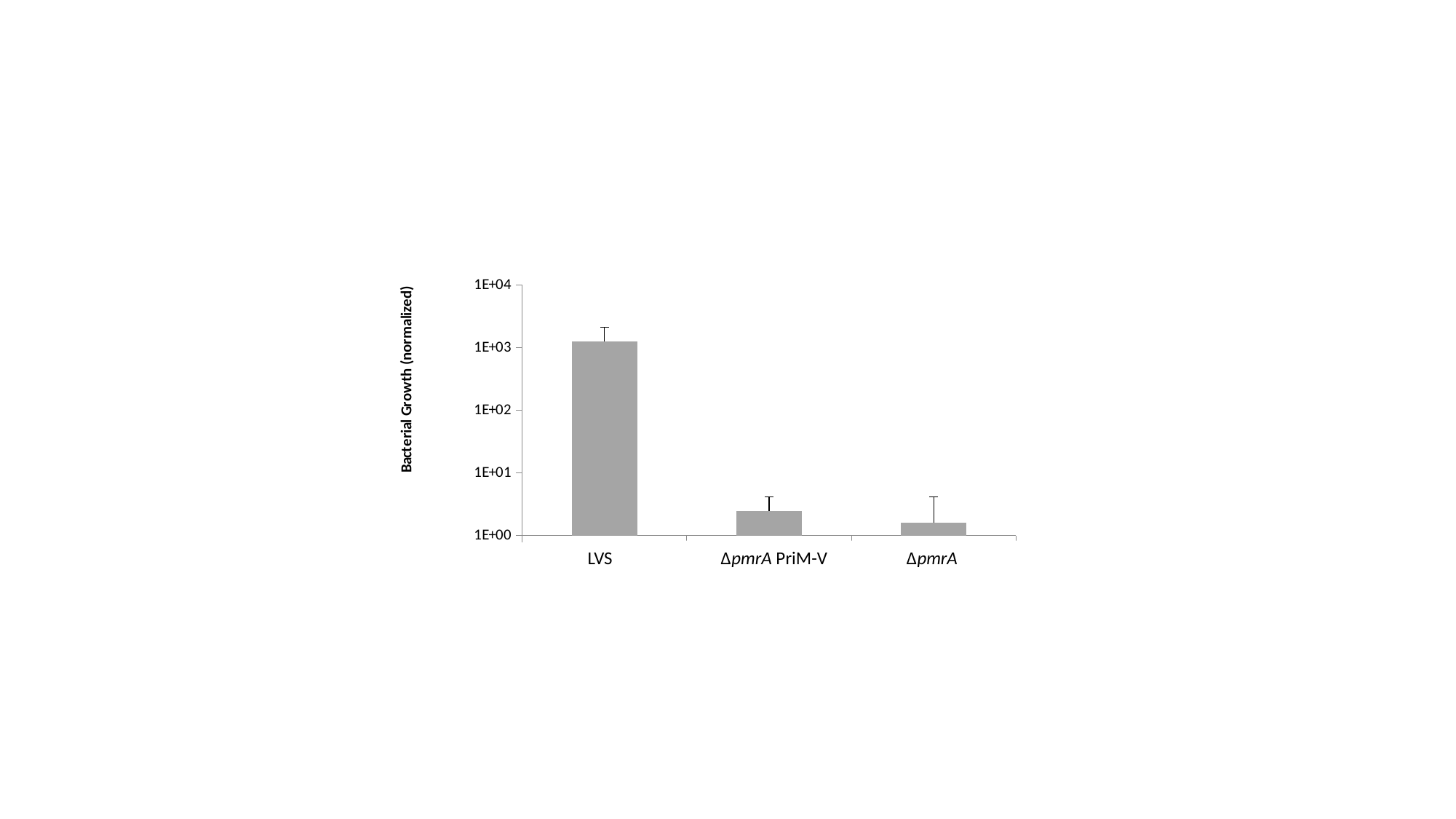
Is the value for LVS greater or less than 1E+02? greater Which has the larger value, ΔpmrA PriM-V or ΔpmrA? ΔpmrA PriM-V Which category has the lowest bacterial growth? ΔpmrA Is the value for ΔpmrA PriM-V greater or less than 1E+01? less What is the label of the y axis? Bacterial Growth (normalized) Which has the larger value, LVS or ΔpmrA PriM-V? LVS What is the highest tick value shown on the y axis? 1E+04 Which category has the highest bacterial growth? LVS How many categories are plotted on the x axis? 3 Is the value for ΔpmrA greater or less than 1E+01? less Do the bar values rise or fall from left to right along the x axis? fall What kind of chart is shown on the slide? Bar chart